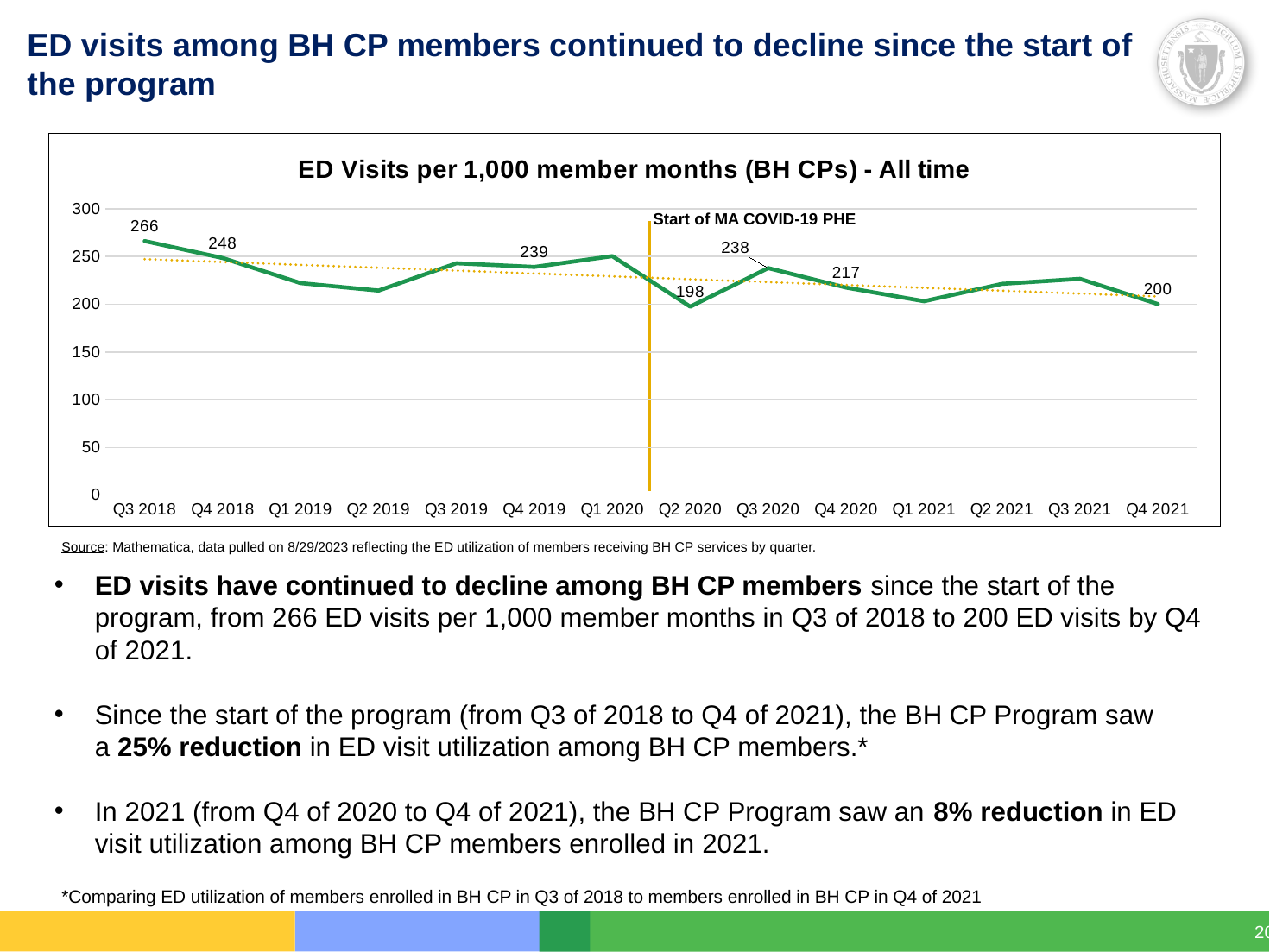
How many quarters are plotted on the x axis? 14 Do the values generally rise or fall from Q3 2018 to Q4 2021? fall What kind of chart is shown on the slide? line chart What is the difference between the values for Q3 2020 and Q2 2020? 40 What is the value for Q2 2020? 198 What is the difference between the values for Q3 2018 and Q4 2021? 66 Which quarter has the highest value of ED visits per 1,000 member months? Q3 2018 What is the value for Q4 2021? 200 Which is larger, the value for Q4 2018 or the value for Q4 2019? Q4 2018 Is the value for Q2 2019 greater or less than 250? less What is the value for Q3 2018 in the ED Visits per 1,000 member months chart? 266 What is the value for Q4 2020? 217